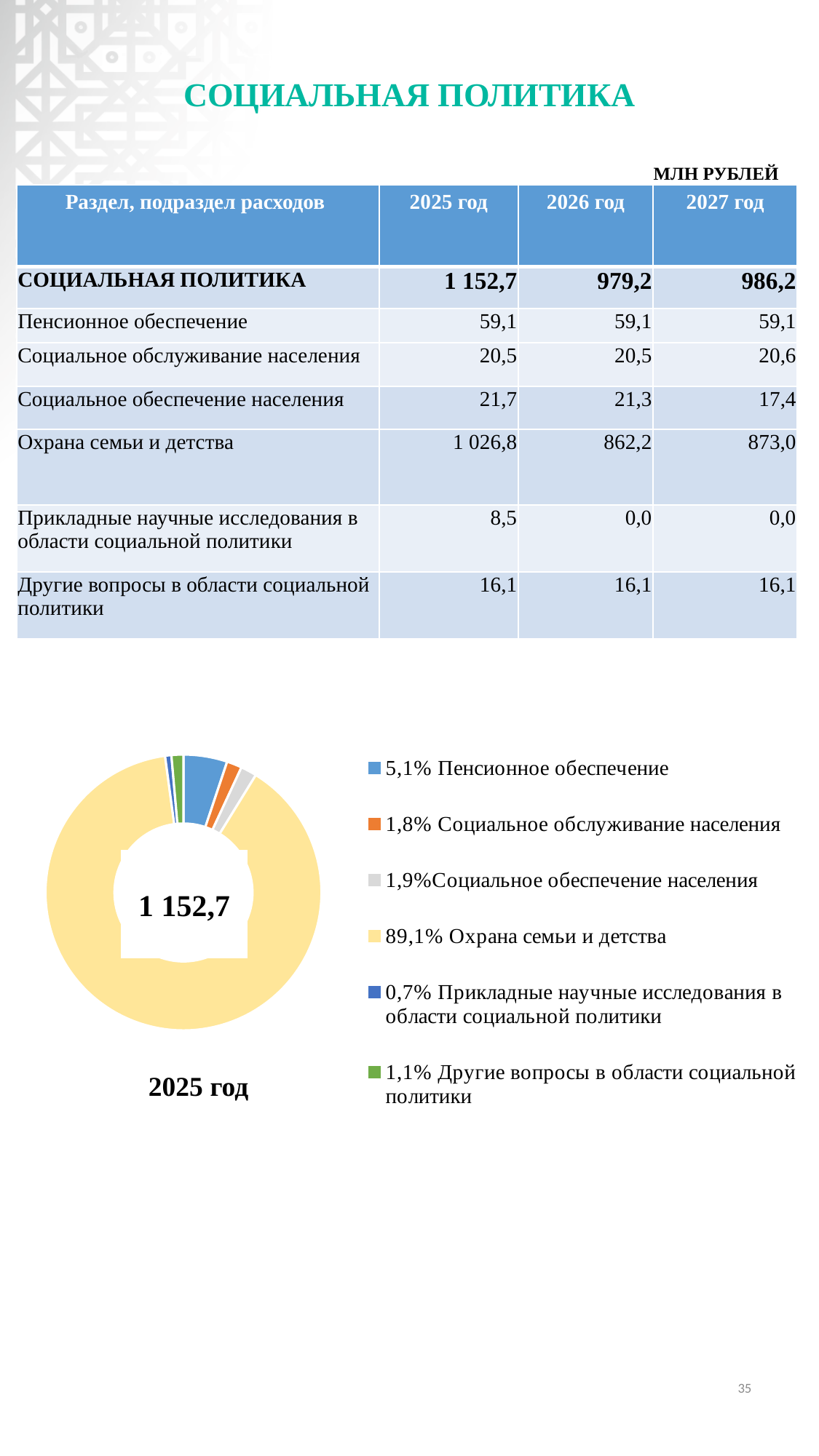
What is the difference in share between Пенсионное обеспечение and Социальное обслуживание населения in the pie chart? 3,3% What share of the pie chart does Прикладные научные исследования в области социальной политики take? 0,7% How many categories does the pie chart legend list? 6 What share of the pie chart does Пенсионное обеспечение take? 5,1% What total value is printed in the centre of the pie chart? 1 152,7 Which slice is larger in the pie chart: Пенсионное обеспечение or Социальное обеспечение населения? Пенсионное обеспечение What share of the pie chart does Социальное обслуживание населения take? 1,8% Which category has the smallest slice in the pie chart? Прикладные научные исследования в области социальной политики Which category has the largest slice in the pie chart? Охрана семьи и детства What kind of chart is shown at the bottom of the slide? Pie (donut) chart